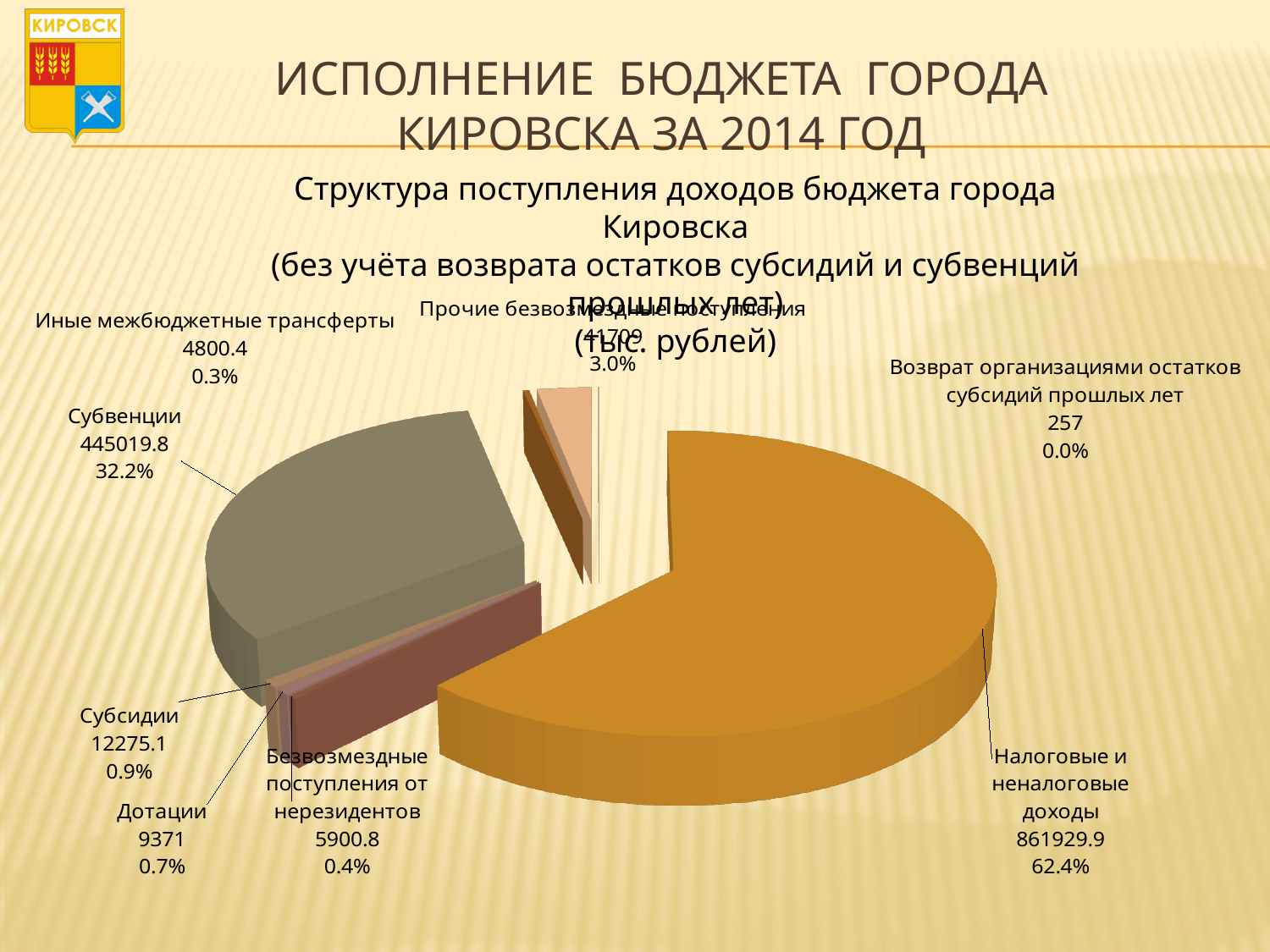
What kind of chart is shown on the slide? pie chart What is the difference between the values for Субсидии and Дотации? 2904.1 What is the value for Субвенции? 445019.8 What share of the pie does Налоговые и неналоговые доходы represent? 62.4% What share of the pie does Субвенции represent? 32.2% Which is larger, the value for Субсидии or the value for Безвозмездные поступления от нерезидентов? Субсидии What is the value for Налоговые и неналоговые доходы? 861929.9 Which category has the smallest slice of the pie? Возврат организациями остатков субсидий прошлых лет What is the value for Дотации? 9371 How many categories are shown in the pie chart? 8 What is the value for Иные межбюджетные трансферты? 4800.4 Which category has the largest slice of the pie? Налоговые и неналоговые доходы